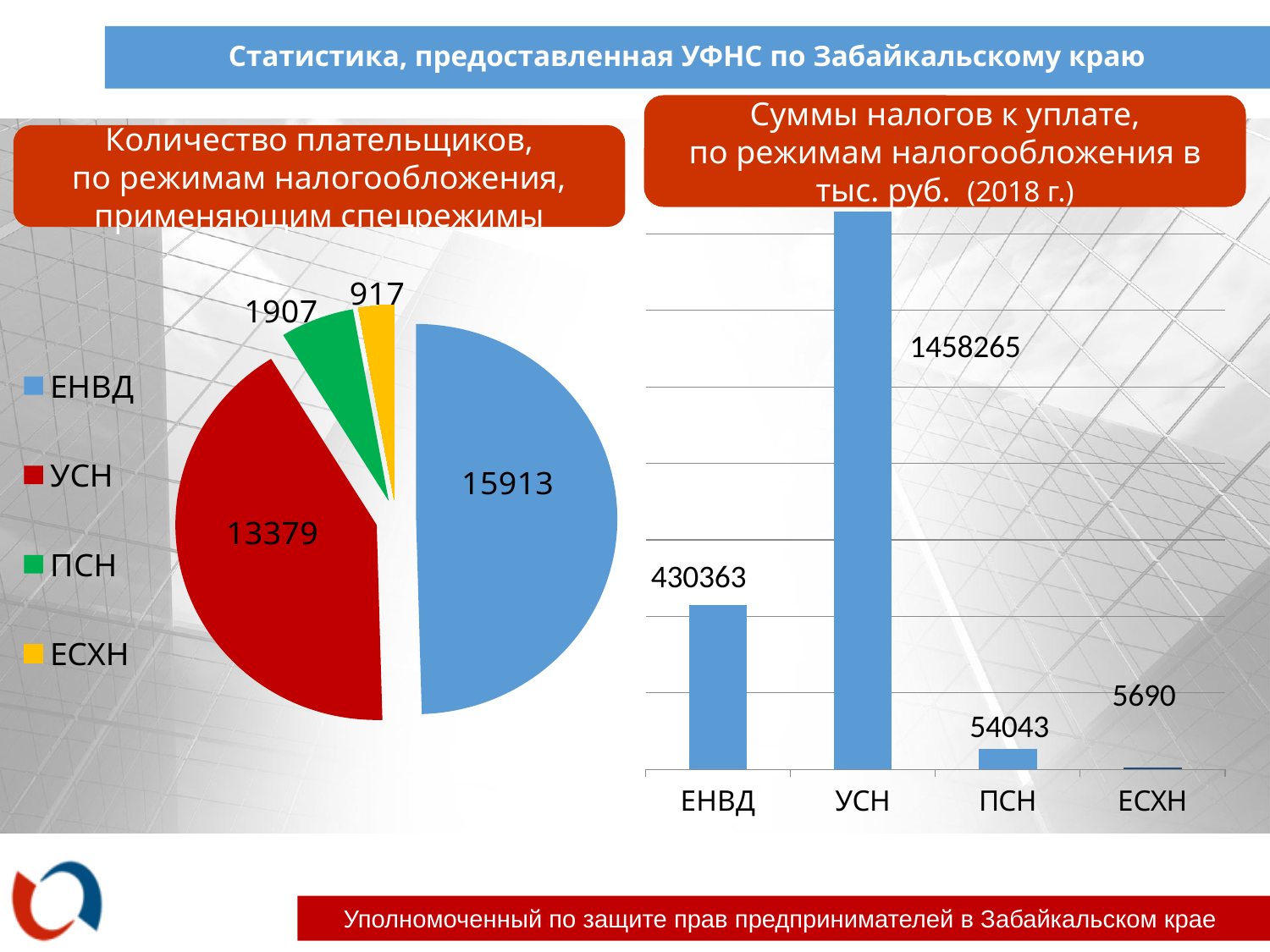
In the bar chart on the right, what is the value for ЕСХН? 5690 In the bar chart on the right, what is the difference between the УСН and ЕНВД values? 1027902 In the pie chart on the left, which regime has the smallest number of payers? ЕСХН In the pie chart on the left, how many slices are there? 4 In the bar chart on the right, which regime has the lowest tax amount? ЕСХН In the pie chart on the left, what is the value for УСН? 13379 What type of chart is shown on the right side of the slide? Bar chart In the bar chart on the right, what is the tax amount to be paid for УСН? 1458265 In the bar chart on the right, which is larger: the value for ЕНВД or the value for ПСН? ЕНВД In the pie chart on the left, how many payers use the ЕНВД regime? 15913 In the pie chart on the left, what is the difference between the ЕНВД and УСН values? 2534 In the pie chart on the left, which regime has the largest number of payers? ЕНВД